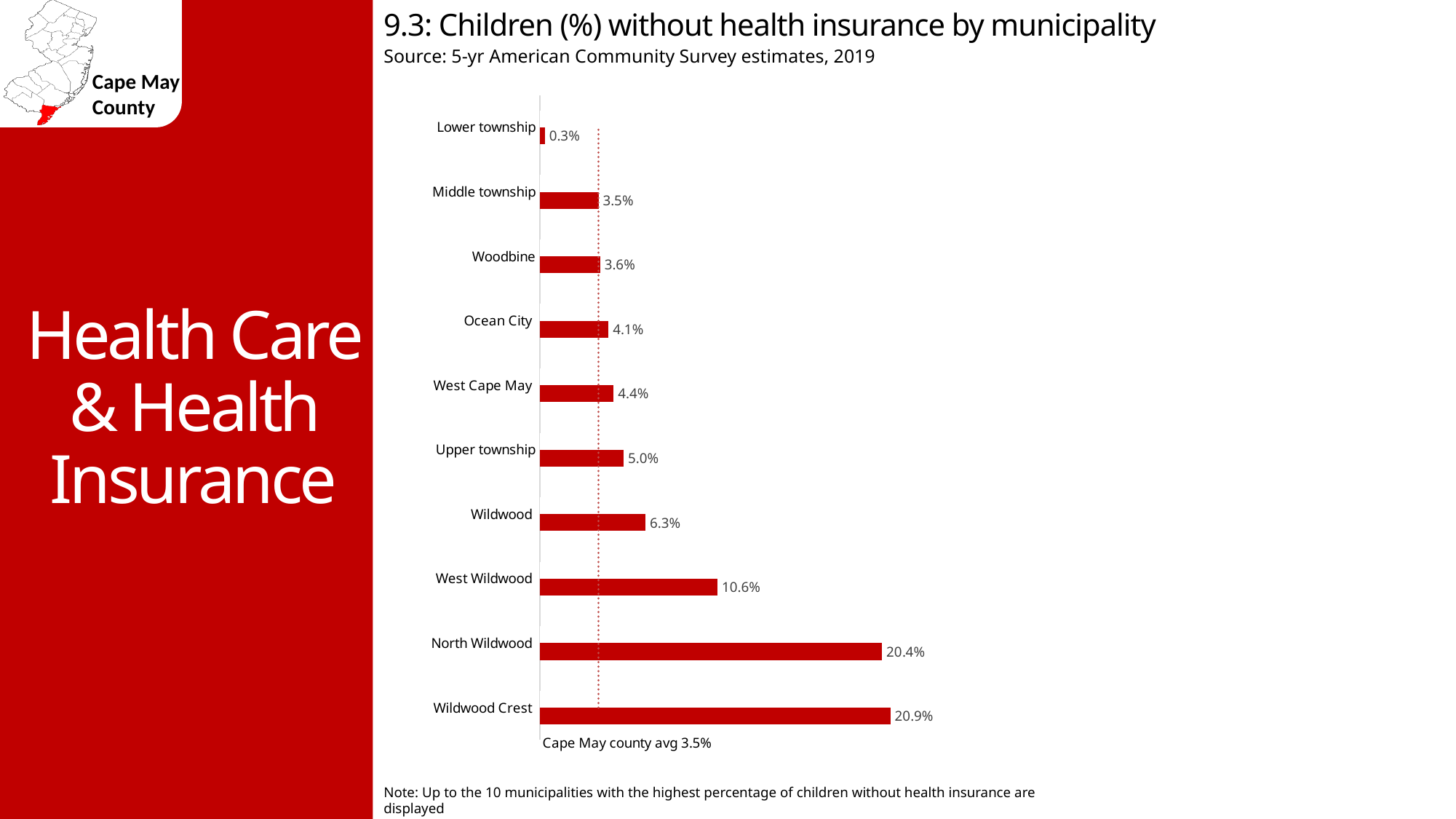
Which municipality has the highest percentage of children without health insurance? Wildwood Crest What is the value shown for Ocean City? 4.1% Which municipality has the lowest percentage of children without health insurance? Lower township What is the difference between the values for North Wildwood and West Wildwood? 9.8% What is the value shown for West Wildwood? 10.6% What is the difference between the values for Wildwood Crest and Lower township? 20.6% Which has a higher value, Wildwood or Upper township? Wildwood What is the Cape May county average shown by the dotted line? 3.5% What kind of chart is shown on the slide? Bar chart What percentage of children are without health insurance in Wildwood Crest? 20.9% How many municipalities are shown in the chart? 10 What is the source of the data shown in the chart? 5-yr American Community Survey estimates, 2019